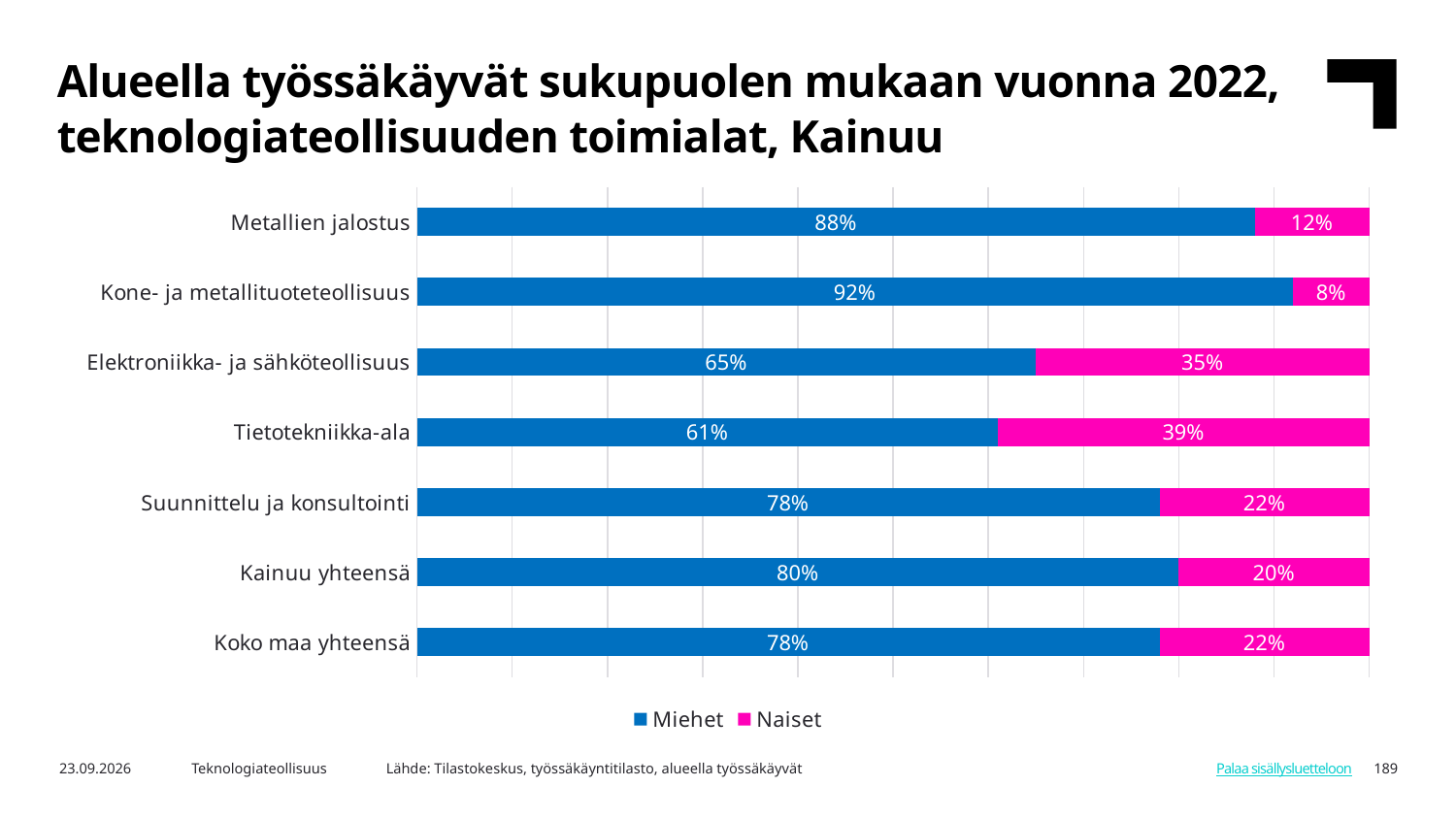
How many series does the legend list? 2 Which category has the highest Naiset share? Tietotekniikka-ala How many categories are shown on the chart? 7 Which category has the lowest Miehet share? Tietotekniikka-ala What is the difference between the Miehet share and the Naiset share for Elektroniikka- ja sähköteollisuus? 30 percentage points Which is larger: the Naiset share for Suunnittelu ja konsultointi or the Naiset share for Kainuu yhteensä? Suunnittelu ja konsultointi Which category has the highest Miehet share? Kone- ja metallituoteteollisuus What is the Miehet share for Metallien jalostus? 88% What is the total of the stacked bar for Koko maa yhteensä? 100% What is the Naiset share for Tietotekniikka-ala? 39% What is the Naiset share for Kainuu yhteensä? 20% What kind of chart is shown on the slide? Stacked bar chart